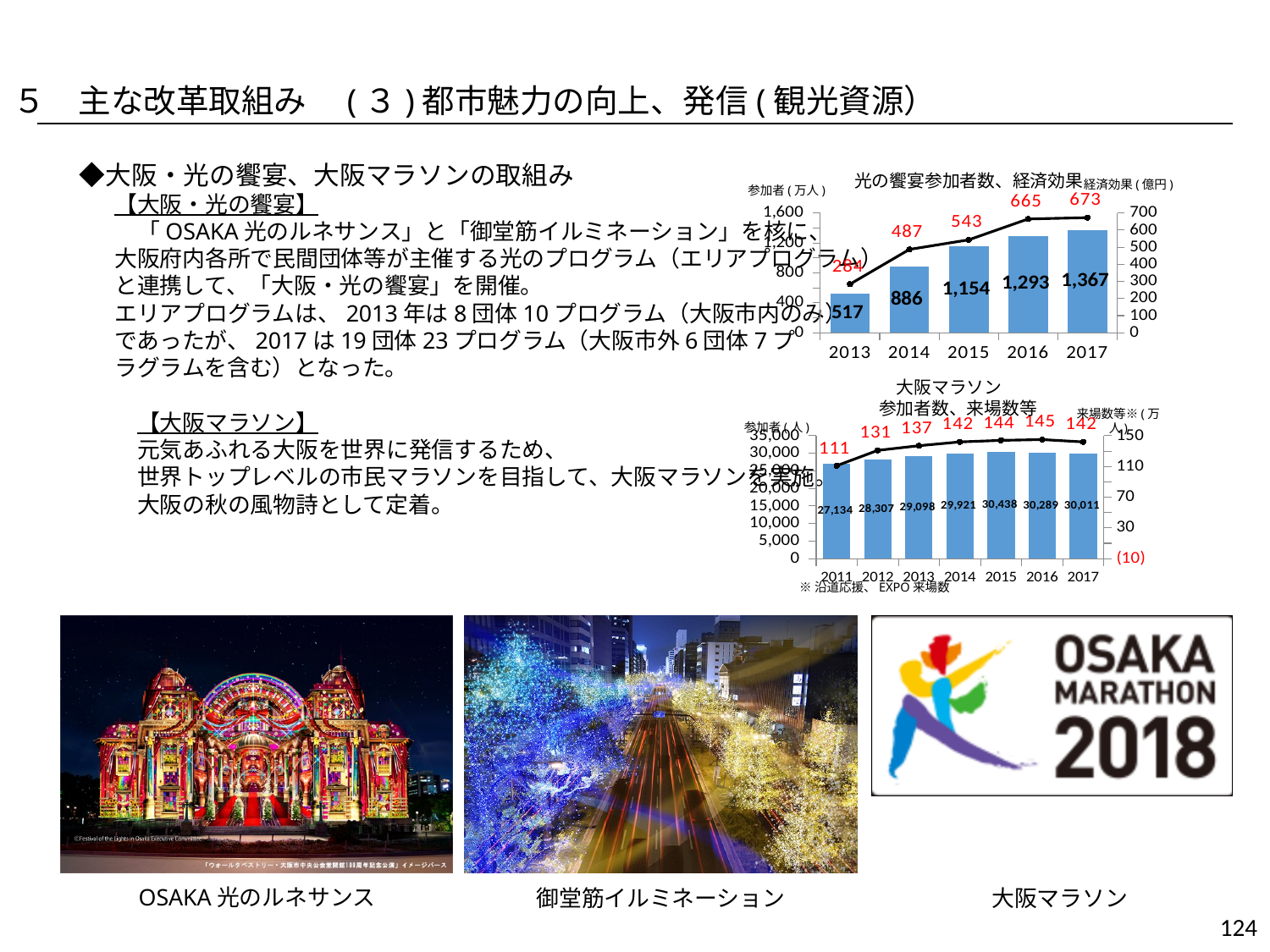
What kind of chart is the 大阪マラソン 参加者数、来場数等 chart? Combined bar and line chart In the 光の饗宴参加者数、経済効果 chart, what is the bar value for 2017? 1,367 In the 大阪マラソン 参加者数、来場数等 chart, what is the line (来場数等) value for 2011? 111 In the 大阪マラソン 参加者数、来場数等 chart, how many years are shown on the x axis? 7 In the 光の饗宴参加者数、経済効果 chart, what is the line (経済効果) value for 2014? 487 In the 大阪マラソン 参加者数、来場数等 chart, which year has the highest line (来場数等) value? 2016 In the 光の饗宴参加者数、経済効果 chart, do the bar values rise or fall from 2013 to 2017? rise In the 光の饗宴参加者数、経済効果 chart, which year has the lowest bar value? 2013 In the 光の饗宴参加者数、経済効果 chart, how many years are shown on the x axis? 5 In the 大阪マラソン 参加者数、来場数等 chart, which is larger, the bar value for 2016 or for 2017? 2016 In the 光の饗宴参加者数、経済効果 chart, what is the difference between the bar values for 2014 and 2013? 369 In the 大阪マラソン 参加者数、来場数等 chart, what is the bar value for 2015? 30,438